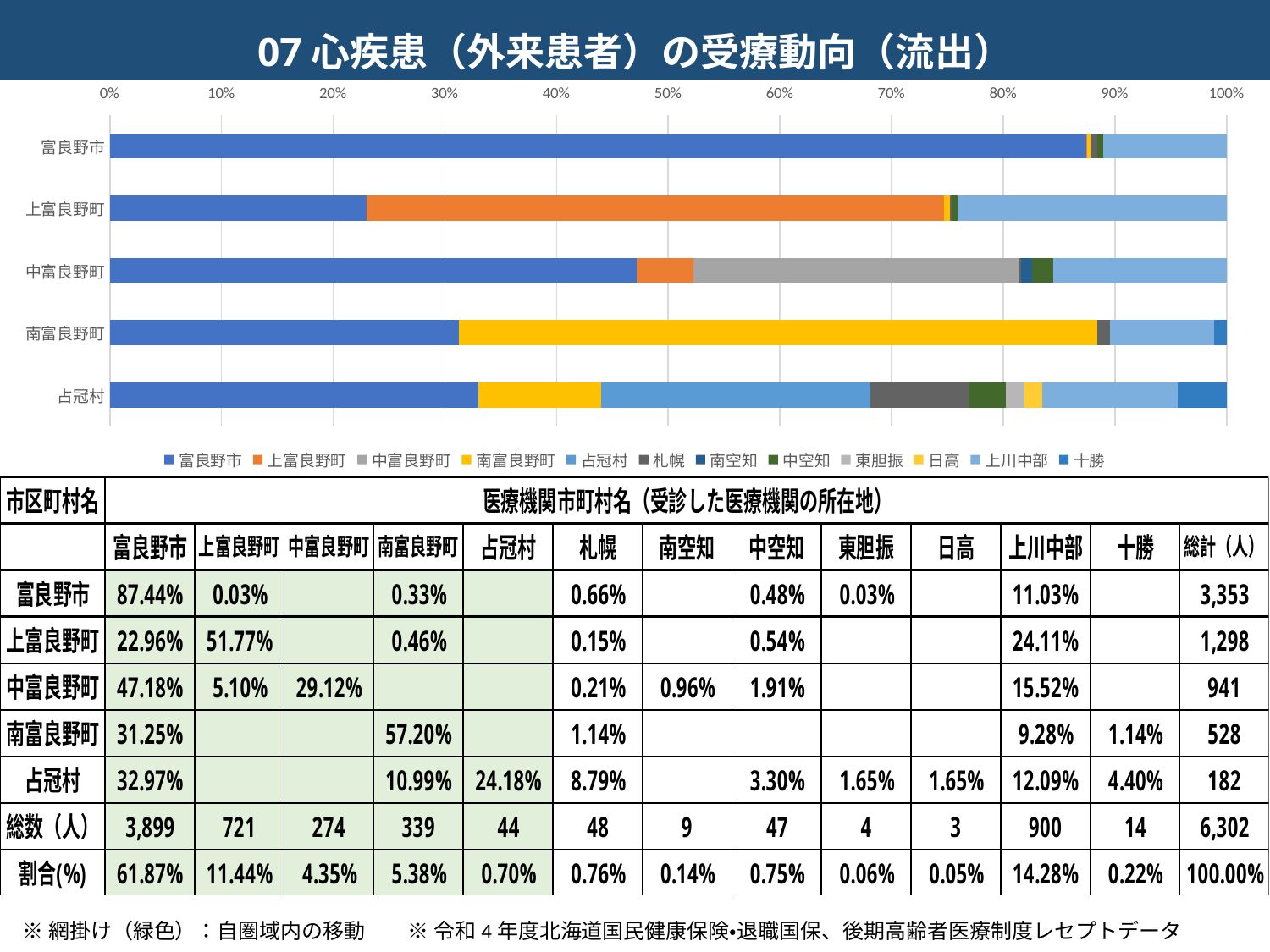
Is the 富良野市 share of the 富良野市 bar greater or less than 80%? greater Which is larger: the 富良野市 share for 中富良野町 (47.18%) or the 中富良野町 share for 中富良野町 (29.12%)? 富良野市 share (47.18%) How many series does the chart legend list? 12 Is the 南富良野町 share of the 南富良野町 bar greater or less than 50%? greater According to the table, what is the total number of patients (総計) for 占冠村? 182 Which municipality has the smallest total number of patients (総計) in the table? 占冠村 According to the table, what percentage of 上富良野町 patients received care in 上川中部? 24.11% What kind of chart is shown on the slide? Stacked bar chart How many municipalities (categories) are plotted on the bar chart? 5 Is the 富良野市 share of the 上富良野町 bar greater or less than 30%? less Which municipality has the largest total number of patients (総計) in the table? 富良野市 According to the table, what percentage of 富良野市 patients received care in 富良野市? 87.44%